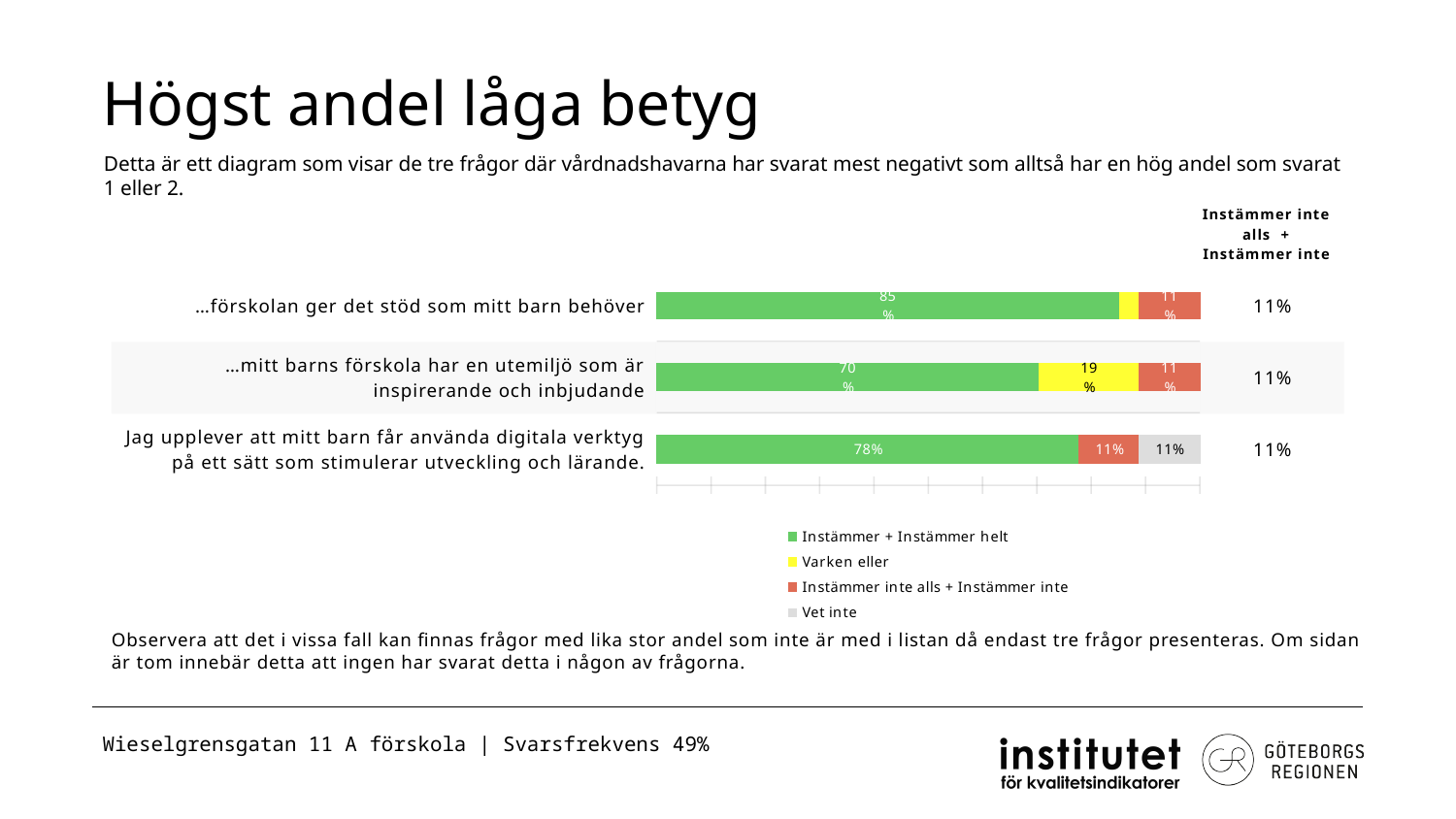
What is the 'Instämmer inte alls + Instämmer inte' value shown in the right-hand column for '…förskolan ger det stöd som mitt barn behöver'? 11% How many questions (categories) are plotted in the chart? 3 What is the value of 'Instämmer + Instämmer helt' for '…mitt barns förskola har en utemiljö som är inspirerande och inbjudande'? 70% What is the difference in 'Instämmer + Instämmer helt' between '…förskolan ger det stöd som mitt barn behöver' and '…mitt barns förskola har en utemiljö som är inspirerande och inbjudande'? 15% How many series does the legend list? 4 What is the value of 'Vet inte' for 'Jag upplever att mitt barn får använda digitala verktyg på ett sätt som stimulerar utveckling och lärande.'? 11% What is the value of 'Instämmer + Instämmer helt' for '…förskolan ger det stöd som mitt barn behöver'? 85% Which question has the highest share of 'Instämmer + Instämmer helt'? …förskolan ger det stöd som mitt barn behöver What is the value of 'Varken eller' for '…mitt barns förskola har en utemiljö som är inspirerande och inbjudande'? 19% What kind of chart is shown on the slide? Stacked bar chart Which question has the lowest share of 'Instämmer + Instämmer helt'? …mitt barns förskola har en utemiljö som är inspirerande och inbjudande What is the value of 'Instämmer + Instämmer helt' for 'Jag upplever att mitt barn får använda digitala verktyg på ett sätt som stimulerar utveckling och lärande.'? 78%